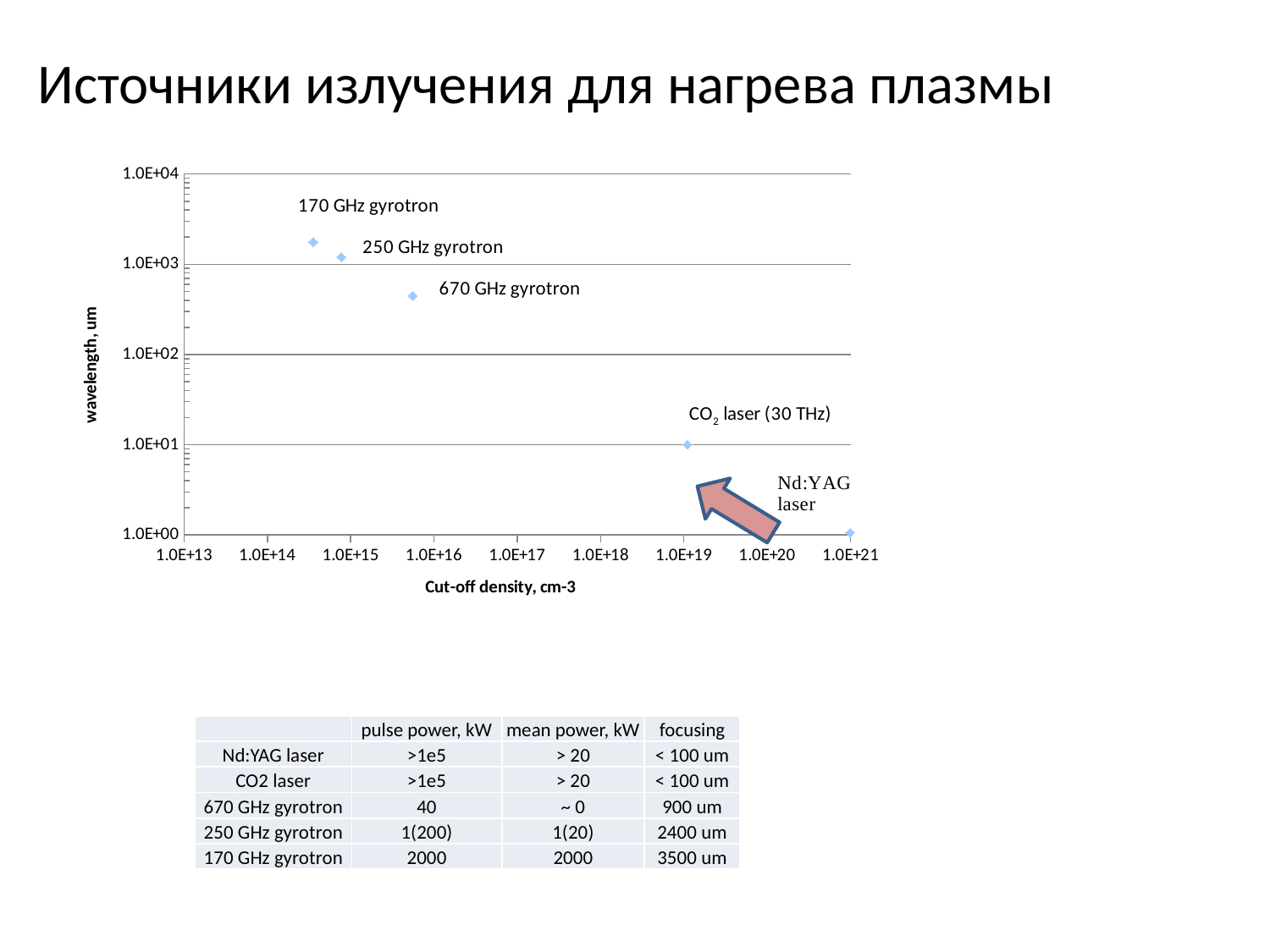
Is the cut-off density for the CO2 laser greater or less than 1.0E+18 cm-3? greater Which has the larger cut-off density, the CO2 laser or the 670 GHz gyrotron? CO2 laser Is the wavelength for the 670 GHz gyrotron greater or less than 1.0E+02 um? greater Which radiation source has the lowest wavelength on the chart? Nd:YAG laser Which radiation source has the highest wavelength on the chart? 170 GHz gyrotron What is the title of the x axis of the chart? Cut-off density, cm-3 Which has the larger wavelength, the 170 GHz gyrotron or the 670 GHz gyrotron? 170 GHz gyrotron How many data points are plotted on the chart? 5 Which source has the lowest cut-off density on the chart? 170 GHz gyrotron As cut-off density increases along the x axis, does the wavelength rise or fall? fall What kind of chart is shown on the slide? scatter chart Which source has the highest cut-off density on the chart? Nd:YAG laser